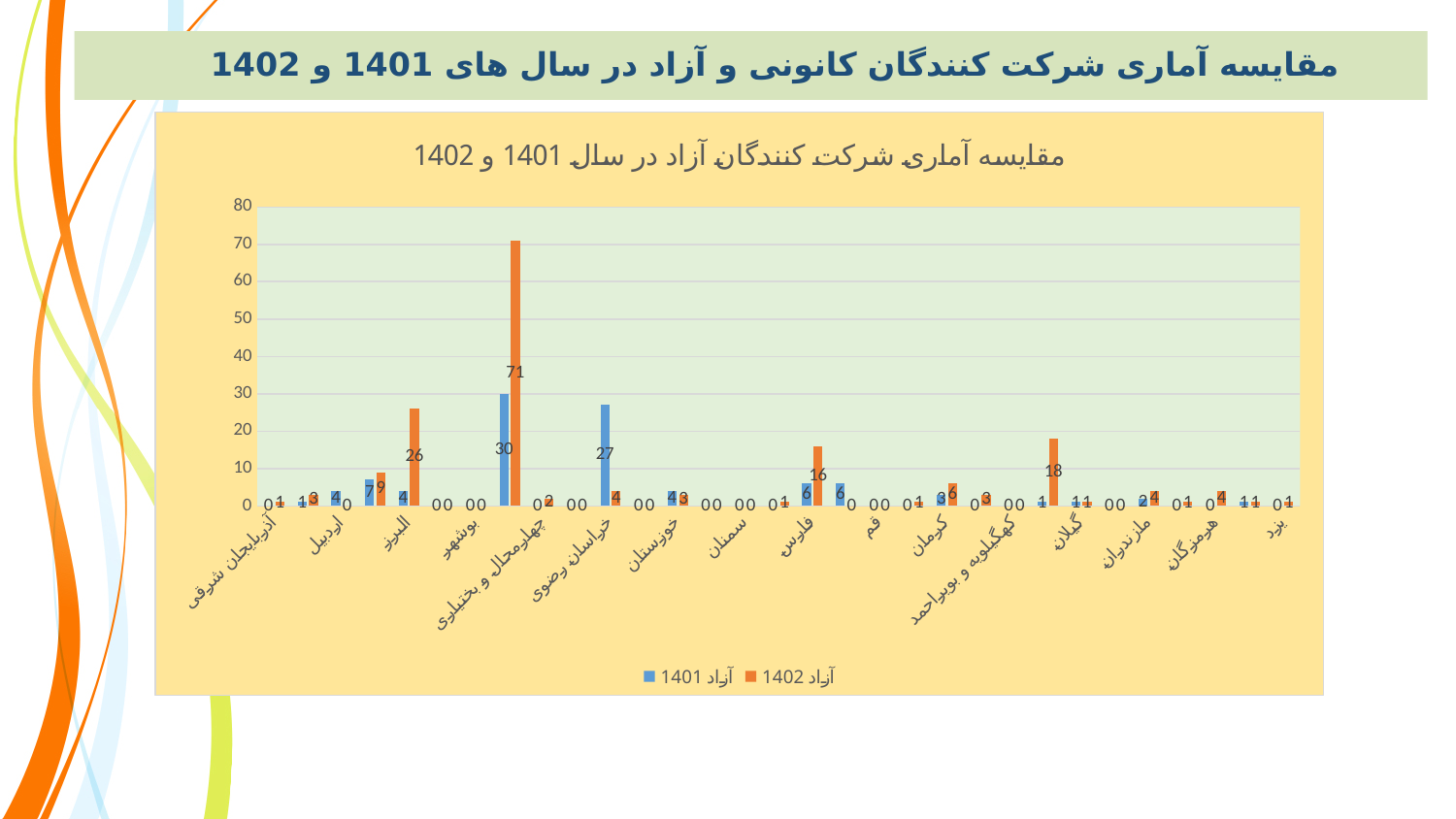
What is the value for گیلان in the آزاد 1402 series? 1 For خراسان رضوی, which series has the larger value, آزاد 1401 or آزاد 1402? آزاد 1401 What are the two series named in the legend? آزاد 1401 and آزاد 1402 What is the value for چهارمحال و بختیاری in the آزاد 1402 series? 2 What is the value for البرز in the آزاد 1402 series? 26 How many series does the chart legend list? 2 What is the difference between the آزاد 1402 and آزاد 1401 values for چهارمحال و بختیاری? 2 What is the value for خراسان رضوی in the آزاد 1401 series? 27 Is the آزاد 1402 value for فارس greater or less than 10? greater What is the value for چهارمحال و بختیاری in the آزاد 1401 series? 0 What kind of chart is shown on the slide? Bar chart